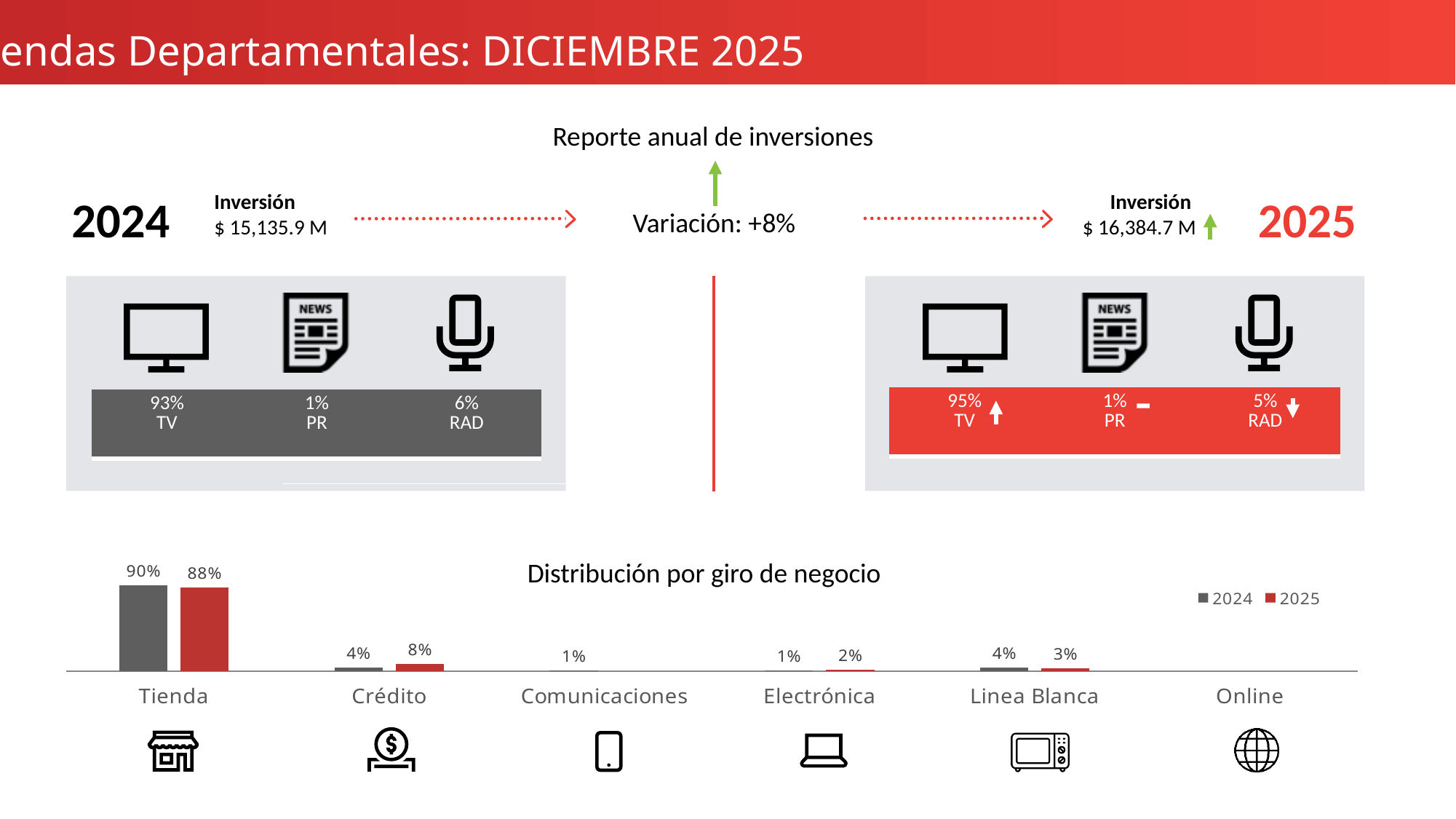
In the 'Distribución por giro de negocio' chart, which is larger for Linea Blanca: the 2024 value or the 2025 value? 2024 In the 'Distribución por giro de negocio' chart, what is the 2025 value for Linea Blanca? 3% In the 'Distribución por giro de negocio' chart, what is the 2025 value for Crédito? 8% How many categories are shown on the x axis of the 'Distribución por giro de negocio' chart? 6 In the 'Distribución por giro de negocio' chart, which is larger for Crédito: the 2024 value or the 2025 value? 2025 In the 'Distribución por giro de negocio' chart, which category has the highest 2025 value? Tienda In the 'Distribución por giro de negocio' chart, what is the 2024 value for Tienda? 90% In the 'Distribución por giro de negocio' chart, what is the difference between the 2024 and 2025 values for Tienda? 2% What kind of chart is 'Distribución por giro de negocio'? Bar chart How many series does the legend of the 'Distribución por giro de negocio' chart list? 2 In the 'Distribución por giro de negocio' chart, what is the difference between the 2025 and 2024 values for Crédito? 4% In the 'Distribución por giro de negocio' chart, what is the 2025 value for Electrónica? 2%